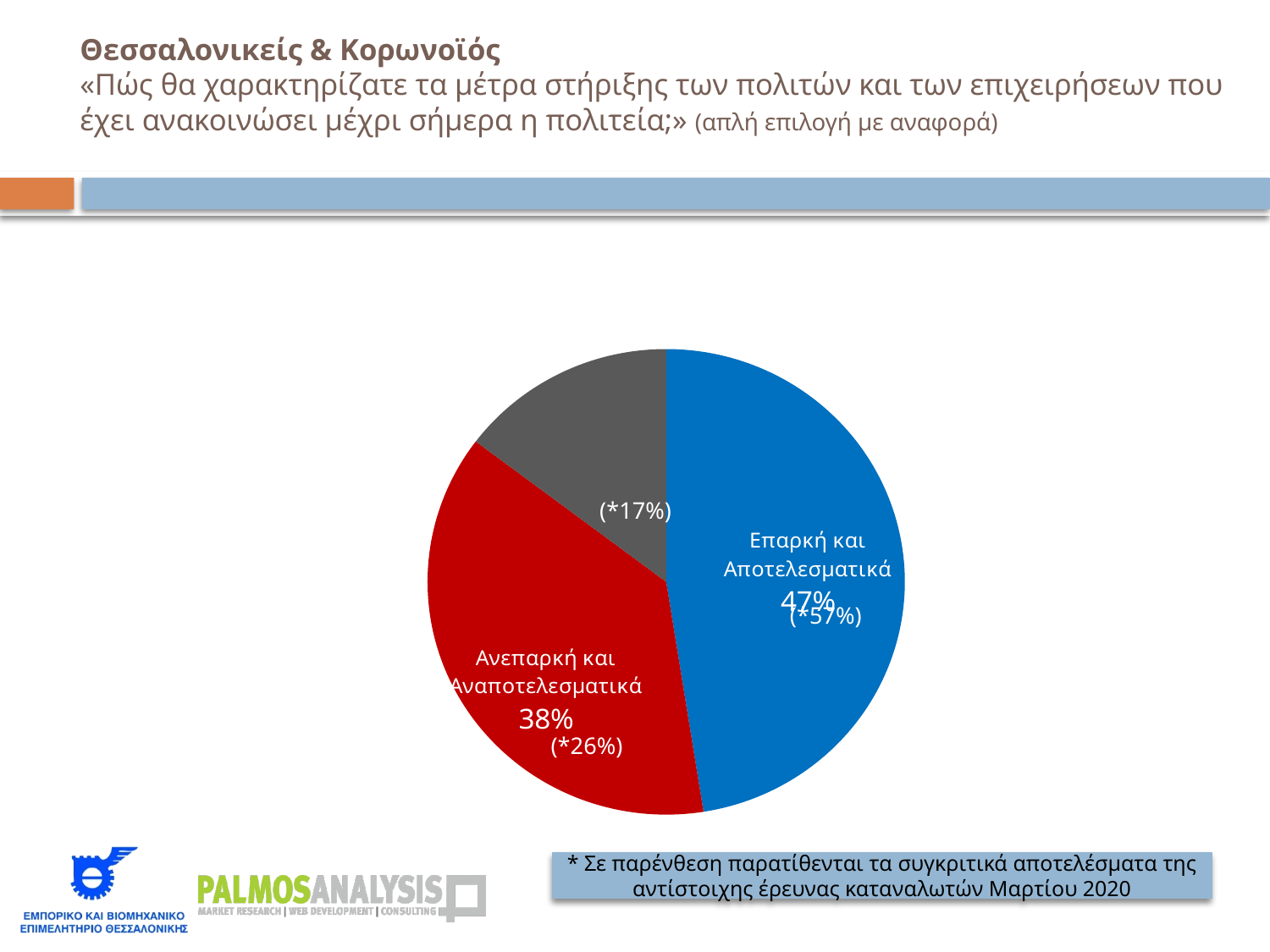
By how many percentage points does «Επαρκή και Αποτελεσματικά» (47%) exceed «Ανεπαρκή και Αναποτελεσματικά» (38%)? 9 percentage points What kind of chart is shown on the slide? Pie chart What was the comparative March 2020 result shown in parentheses for «Επαρκή και Αποτελεσματικά»? 57% What colour is the «Ανεπαρκή και Αναποτελεσματικά» slice? Red What share of respondents answered «Επαρκή και Αποτελεσματικά»? 47% Which is larger: the share for «Επαρκή και Αποτελεσματικά» or for «Ανεπαρκή και Αναποτελεσματικά»? Επαρκή και Αποτελεσματικά Did the share for «Επαρκή και Αποτελεσματικά» rise or fall compared with the March 2020 value in parentheses? Fall (from 57% to 47%) What share of respondents answered «Ανεπαρκή και Αναποτελεσματικά»? 38% How many slices does the pie chart have? 3 Which labelled slice of the pie is the largest? Επαρκή και Αποτελεσματικά In the March 2020 comparison values, what is the difference between «Επαρκή και Αποτελεσματικά» (57%) and «Ανεπαρκή και Αναποτελεσματικά» (26%)? 31 percentage points What was the comparative March 2020 result shown in parentheses for «Ανεπαρκή και Αναποτελεσματικά»? 26%